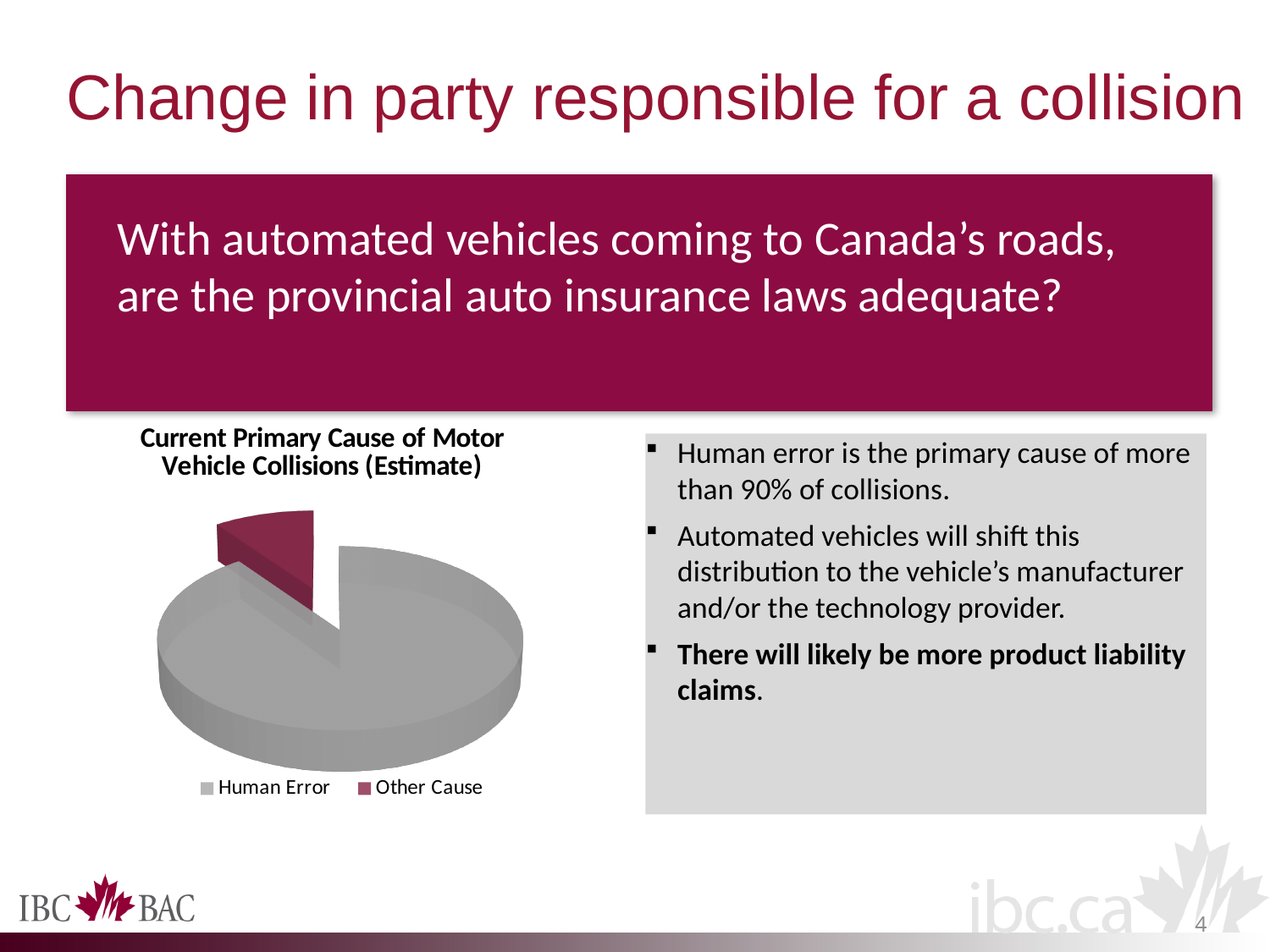
Which category has the largest slice in the pie chart? Human Error What colour is the Other Cause slice in the pie chart? maroon Which category has the smallest slice in the pie chart? Other Cause What is the title of the pie chart? Current Primary Cause of Motor Vehicle Collisions (Estimate) How many slices does the pie chart have? 2 How many entries does the legend of the pie chart list? 2 Which slice is larger in the pie chart, Human Error or Other Cause? Human Error What kind of chart is shown on the slide? pie chart